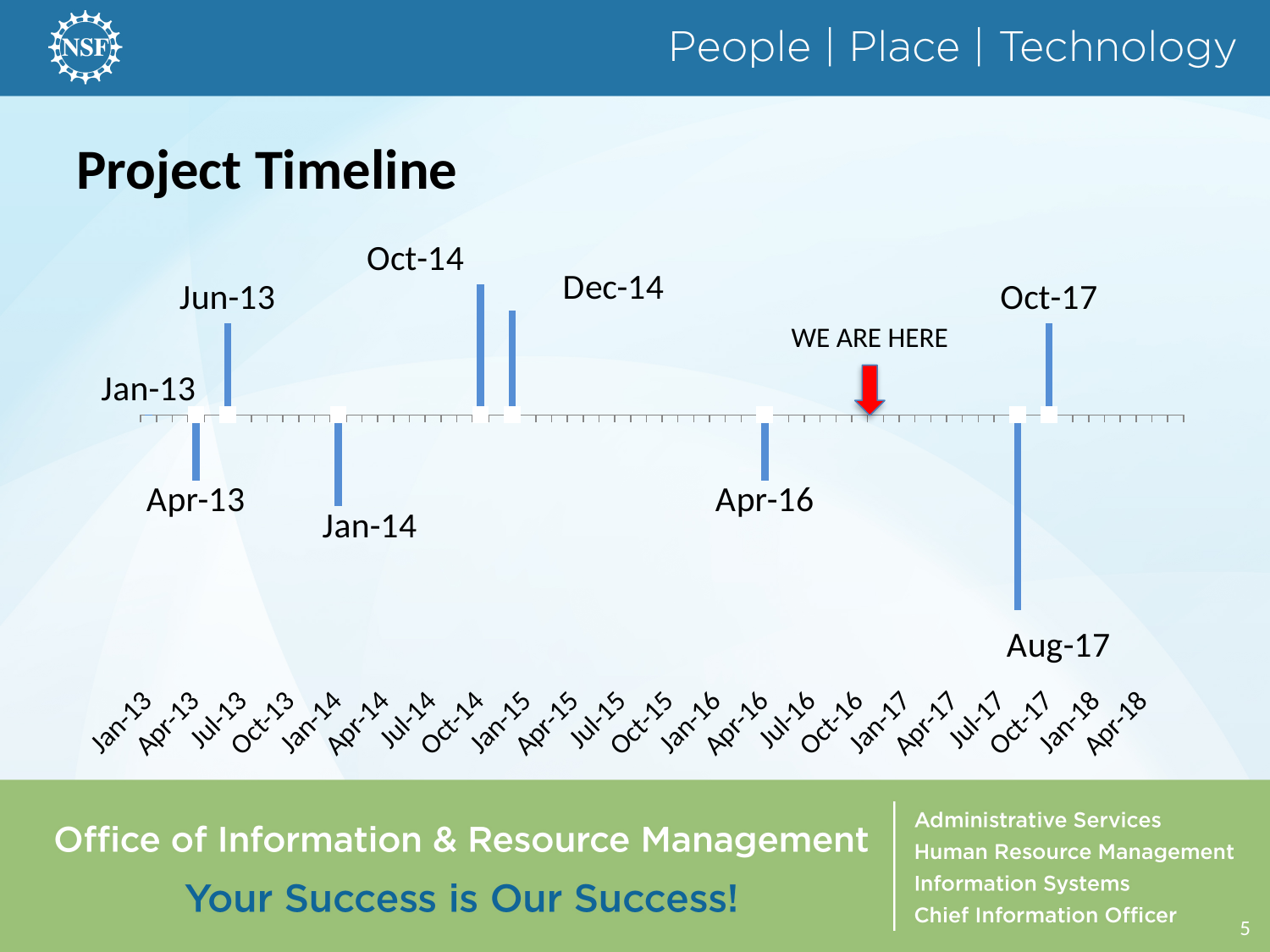
How many milestones are marked on the Project Timeline? 9 What is the last tick label on the x axis of the Project Timeline? Apr-18 Which milestone comes immediately before Oct-17 on the Project Timeline? Aug-17 What is the title of the chart on the slide? Project Timeline Which milestone comes immediately after Jun-13 on the Project Timeline? Jan-14 What is the earliest milestone labelled on the Project Timeline? Jan-13 What is the first tick label on the x axis of the Project Timeline? Jan-13 What is the latest milestone labelled on the Project Timeline? Oct-17 Is the 'WE ARE HERE' marker positioned before or after the Aug-17 milestone? before Which milestone comes immediately after Dec-14 on the Project Timeline? Apr-16 Is the 'WE ARE HERE' marker positioned before or after the Apr-16 milestone? after What kind of chart is shown on the slide? Bar chart